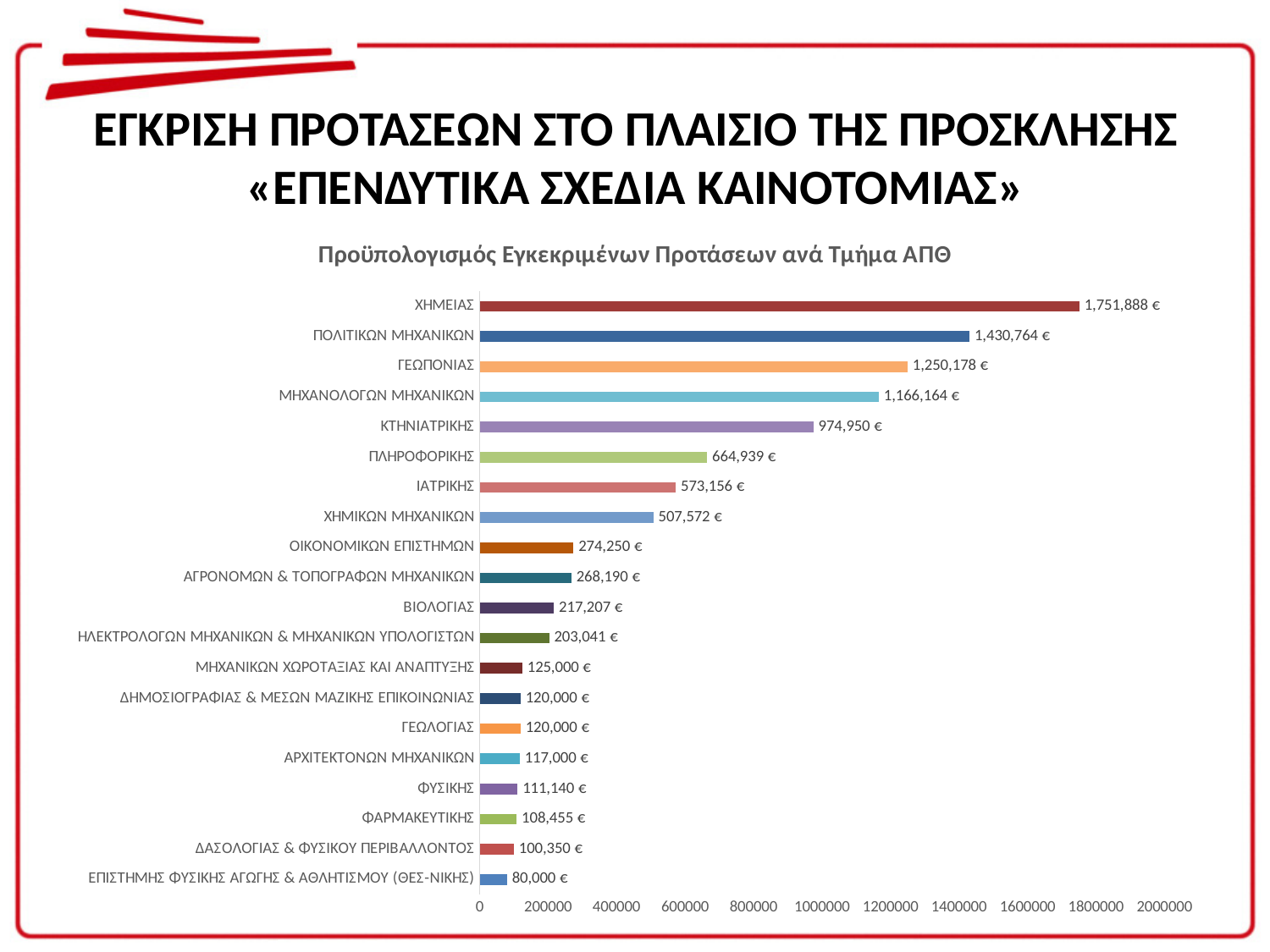
How many departments are shown in the chart? 20 What is the difference between the budgets of ΚΤΗΝΙΑΤΡΙΚΗΣ and ΠΛΗΡΟΦΟΡΙΚΗΣ? 310,011 € What is the approved budget for ΒΙΟΛΟΓΙΑΣ? 217,207 € Which department has the lowest approved budget? ΕΠΙΣΤΗΜΗΣ ΦΥΣΙΚΗΣ ΑΓΩΓΗΣ & ΑΘΛΗΤΙΣΜΟΥ (ΘΕΣ-ΝΙΚΗΣ) Which department has the highest approved budget? ΧΗΜΕΙΑΣ Which has a larger approved budget, ΓΕΩΠΟΝΙΑΣ or ΜΗΧΑΝΟΛΟΓΩΝ ΜΗΧΑΝΙΚΩΝ? ΓΕΩΠΟΝΙΑΣ What type of chart is shown on the slide? Bar chart What is the difference between the budgets of ΧΗΜΕΙΑΣ and ΠΟΛΙΤΙΚΩΝ ΜΗΧΑΝΙΚΩΝ? 321,124 € What is the approved budget for ΧΗΜΕΙΑΣ? 1,751,888 € What is the approved budget for ΚΤΗΝΙΑΤΡΙΚΗΣ? 974,950 € Is the value for ΙΑΤΡΙΚΗΣ greater or less than 600000? less What is the title of the chart? Προϋπολογισμός Εγκεκριμένων Προτάσεων ανά Τμήμα ΑΠΘ